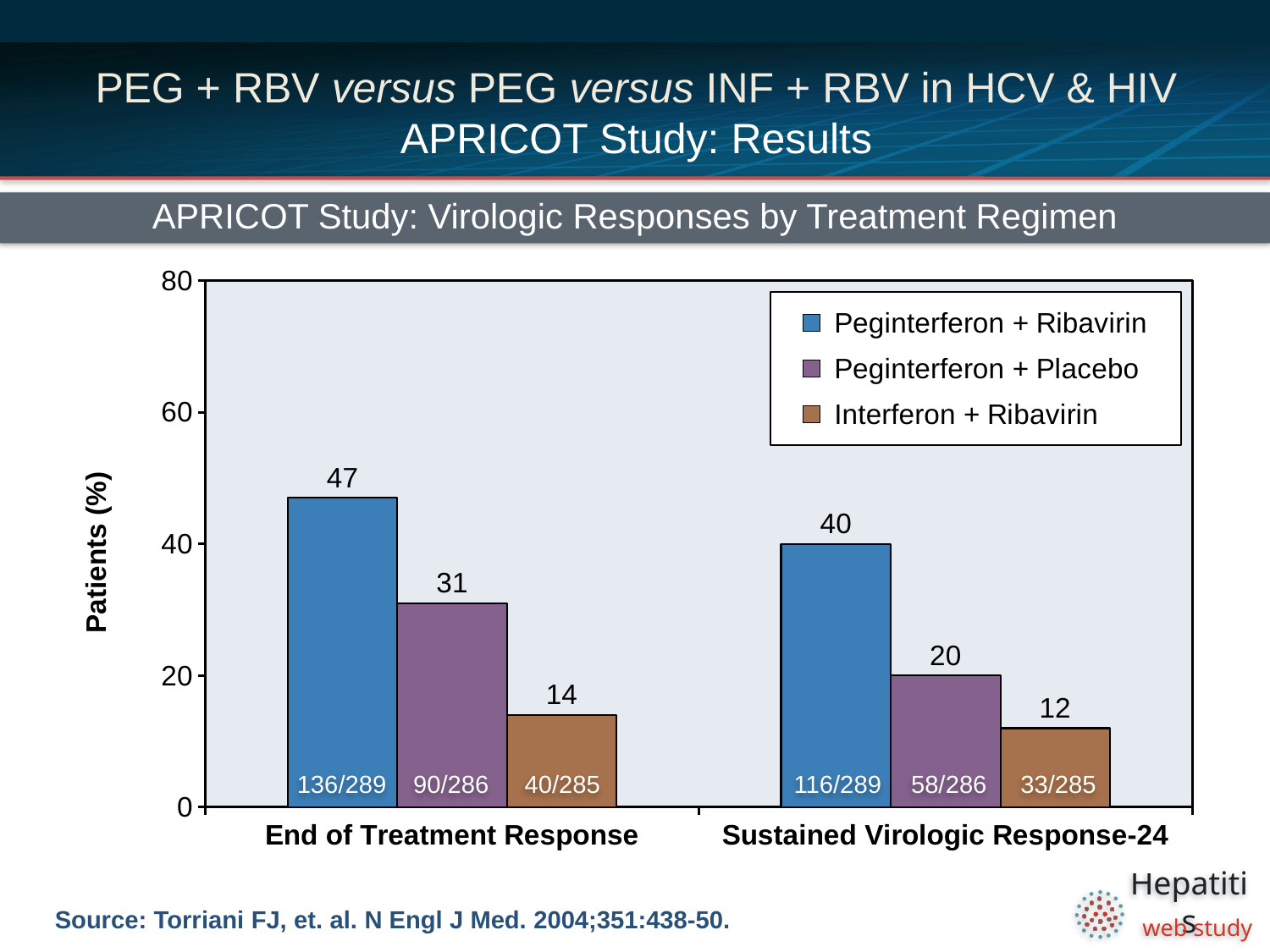
What is the value for Peginterferon + Ribavirin in the End of Treatment Response category? 47 Which is larger: Peginterferon + Placebo in End of Treatment Response or Peginterferon + Ribavirin in Sustained Virologic Response-24? Peginterferon + Ribavirin in Sustained Virologic Response-24 How many categories are shown on the x axis? 2 What is the label on the y axis of the chart? Patients (%) Which series has the highest value in the End of Treatment Response category? Peginterferon + Ribavirin What is the difference between the Peginterferon + Ribavirin and Peginterferon + Placebo values in the End of Treatment Response category? 16 Which series has the lowest value in the Sustained Virologic Response-24 category? Interferon + Ribavirin What is the value for Peginterferon + Placebo in the Sustained Virologic Response-24 category? 20 Is the value for Interferon + Ribavirin in the End of Treatment Response category greater or less than 20? less What is the value for Interferon + Ribavirin in the Sustained Virologic Response-24 category? 12 How many series does the legend list? 3 What kind of chart is shown on the slide? bar chart